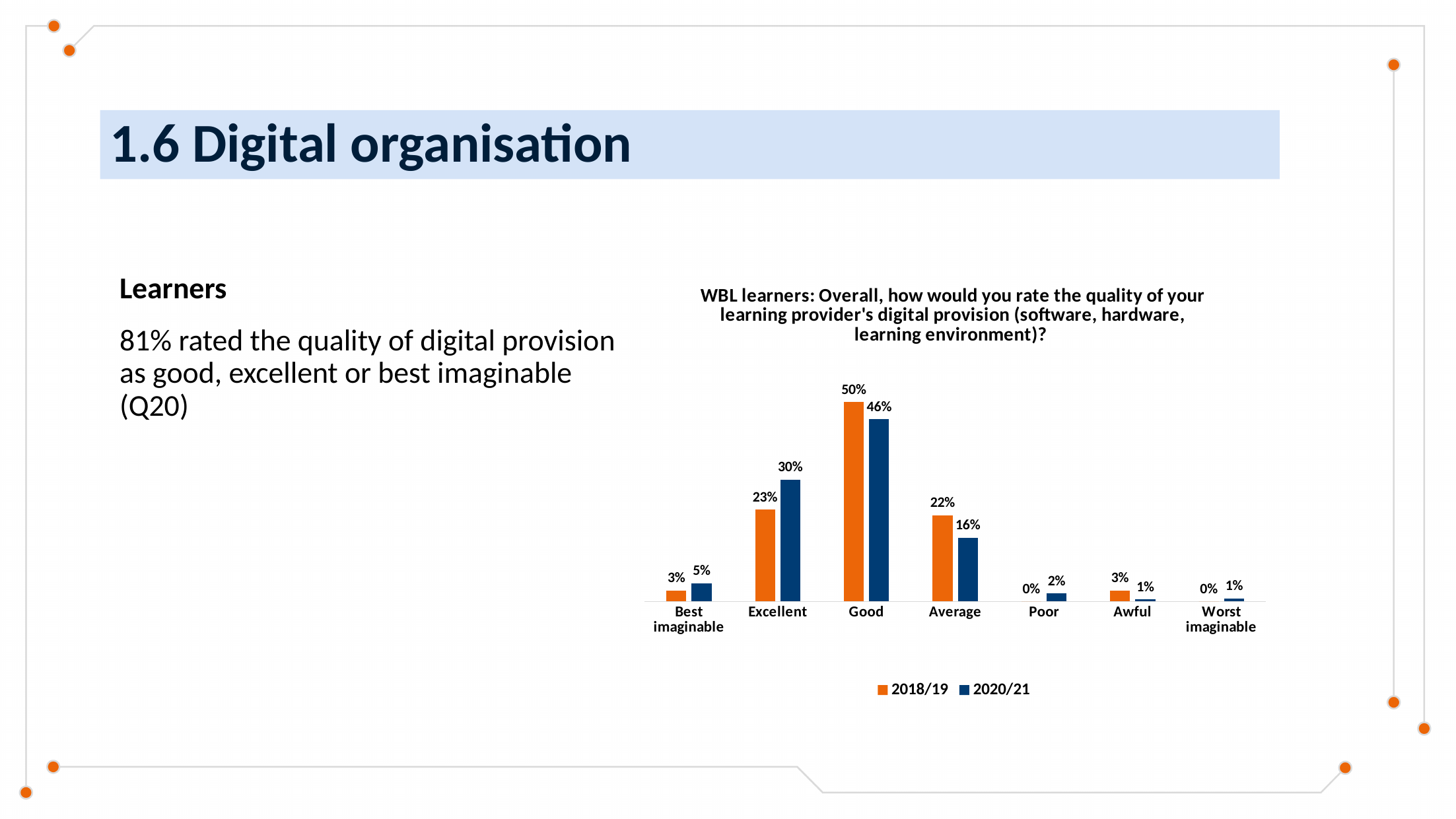
Which colour represents the 2020/21 series in the chart? Dark blue What percentage of WBL learners rated digital provision as Excellent in 2018/19? 23% Which rating category has the highest value for 2018/19? Good What is the 2020/21 value for Average? 16% Which is larger for Average: the 2018/19 value or the 2020/21 value? 2018/19 Which rating category has the lowest value for 2020/21? Awful and Worst imaginable (both 1%) How many rating categories are shown on the x axis? 7 What percentage of WBL learners rated digital provision as Good in 2020/21? 46% What is the difference between the 2018/19 and 2020/21 values for Good? 4% What kind of chart is shown on the slide? Bar chart How many series does the legend list? 2 What is the difference between the 2020/21 and 2018/19 values for Excellent? 7%